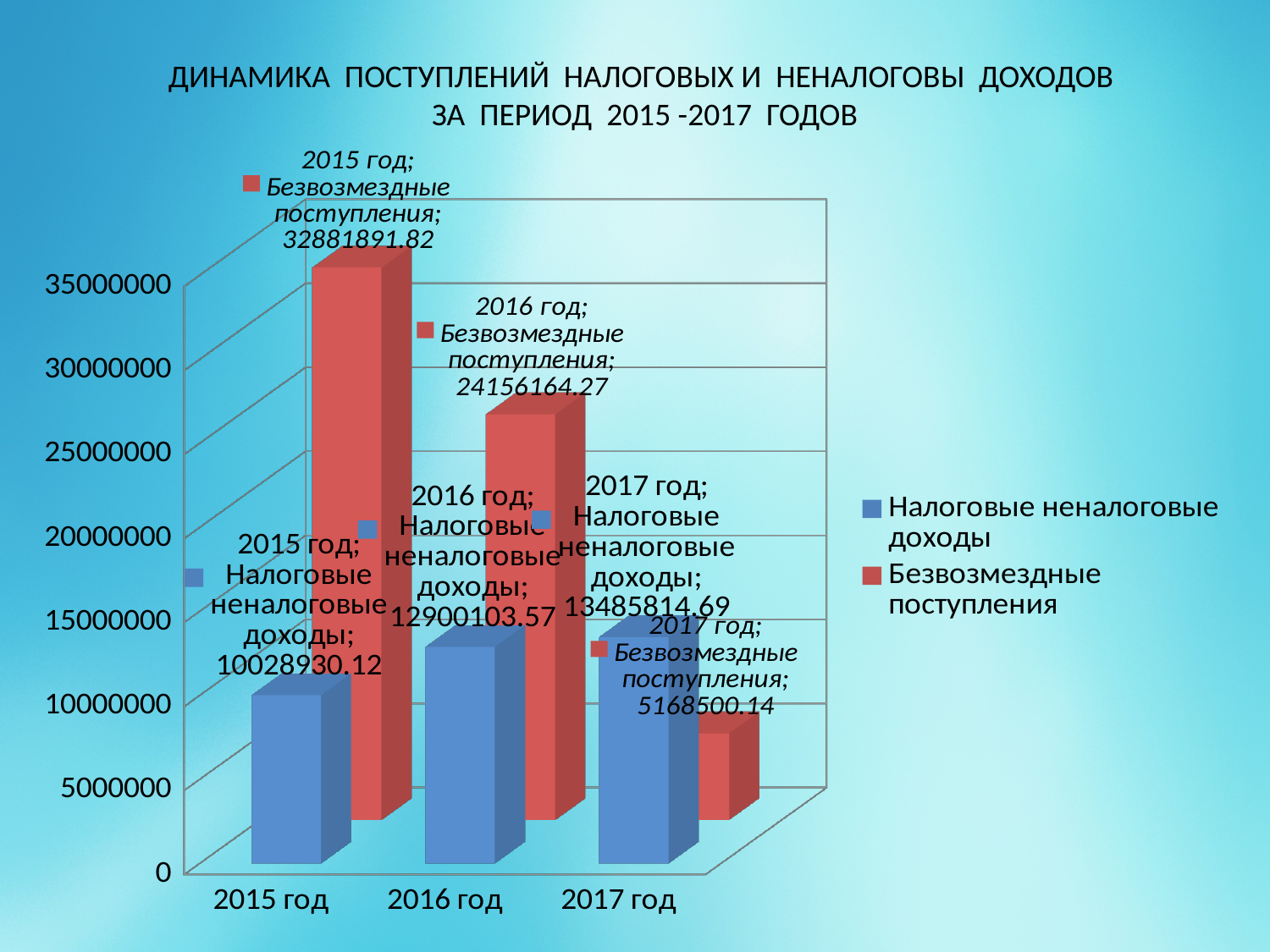
Do the values of Безвозмездные поступления rise or fall from 2015 год to 2017 год? Fall What is the value of Безвозмездные поступления for 2016 год? 24156164.27 How many series does the legend list? 2 What kind of chart is shown on the slide? Bar chart In which year is Безвозмездные поступления highest? 2015 год What is the value of Налоговые неналоговые доходы for 2017 год? 13485814.69 How many years are shown on the x axis? 3 What is the value of Безвозмездные поступления for 2017 год? 5168500.14 Which is larger in 2017 год: Налоговые неналоговые доходы or Безвозмездные поступления? Налоговые неналоговые доходы What is the value of Налоговые неналоговые доходы for 2015 год? 10028930.12 In which year is Налоговые неналоговые доходы lowest? 2015 год What is the difference between Безвозмездные поступления and Налоговые неналоговые доходы in 2016 год? 11256060.70